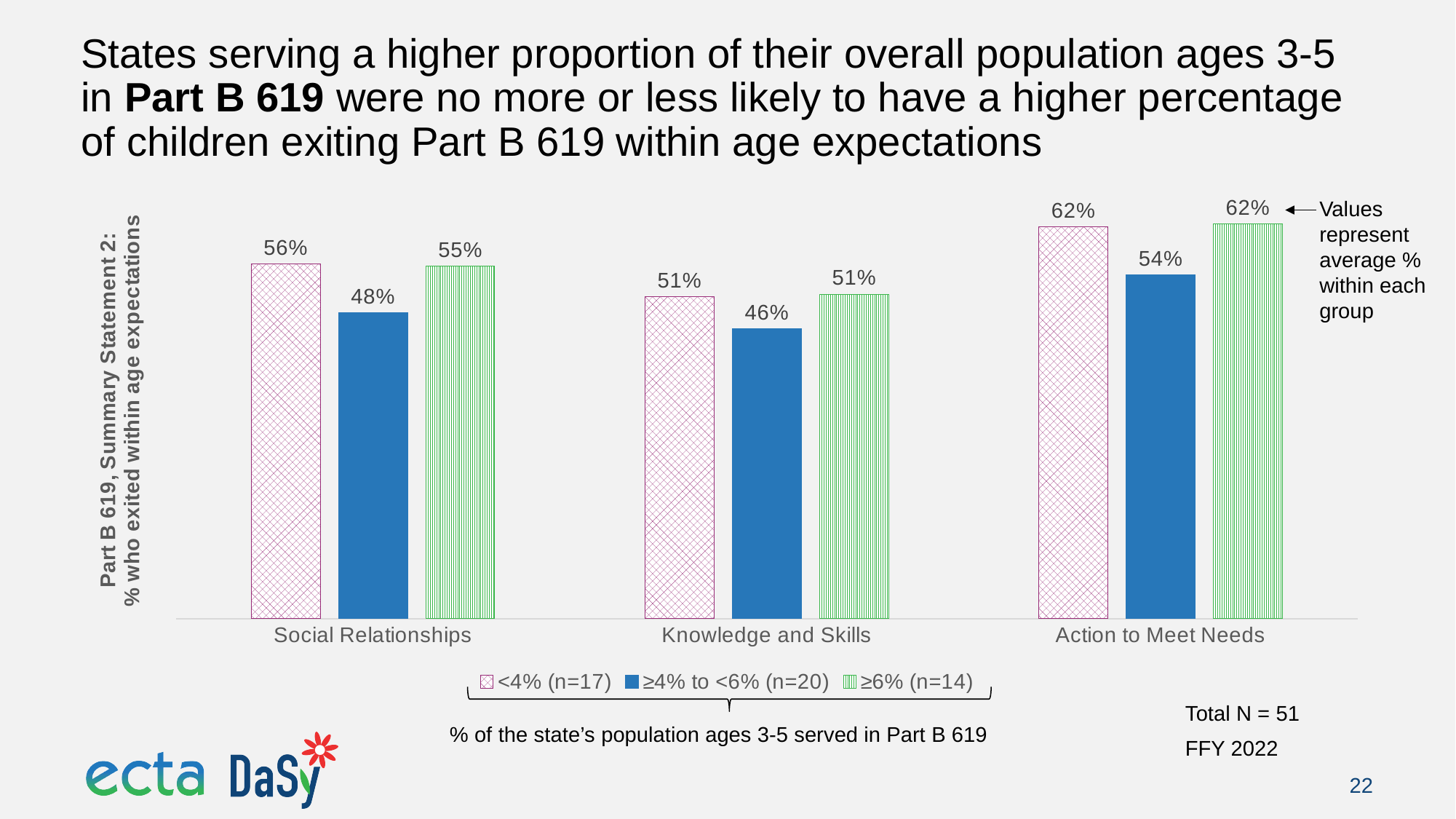
What is the total N shown on the slide? 51 What is the value for the ≥4% to <6% (n=20) group in Knowledge and Skills? 46% How many series does the legend list? 3 In Action to Meet Needs, which is larger: the <4% (n=17) group or the ≥4% to <6% (n=20) group? <4% (n=17) Which fiscal year does the chart report? FFY 2022 How many outcome categories are shown on the x axis? 3 Which outcome category has the lowest value for the <4% (n=17) group? Knowledge and Skills What is the value for the ≥6% (n=14) group in Action to Meet Needs? 62% What kind of chart is shown on the slide? Bar chart What is the value for the <4% (n=17) group in Social Relationships? 56% What is the difference between the <4% (n=17) group and the ≥4% to <6% (n=20) group in Social Relationships? 8 percentage points Which outcome category has the highest value for the ≥4% to <6% (n=20) group? Action to Meet Needs